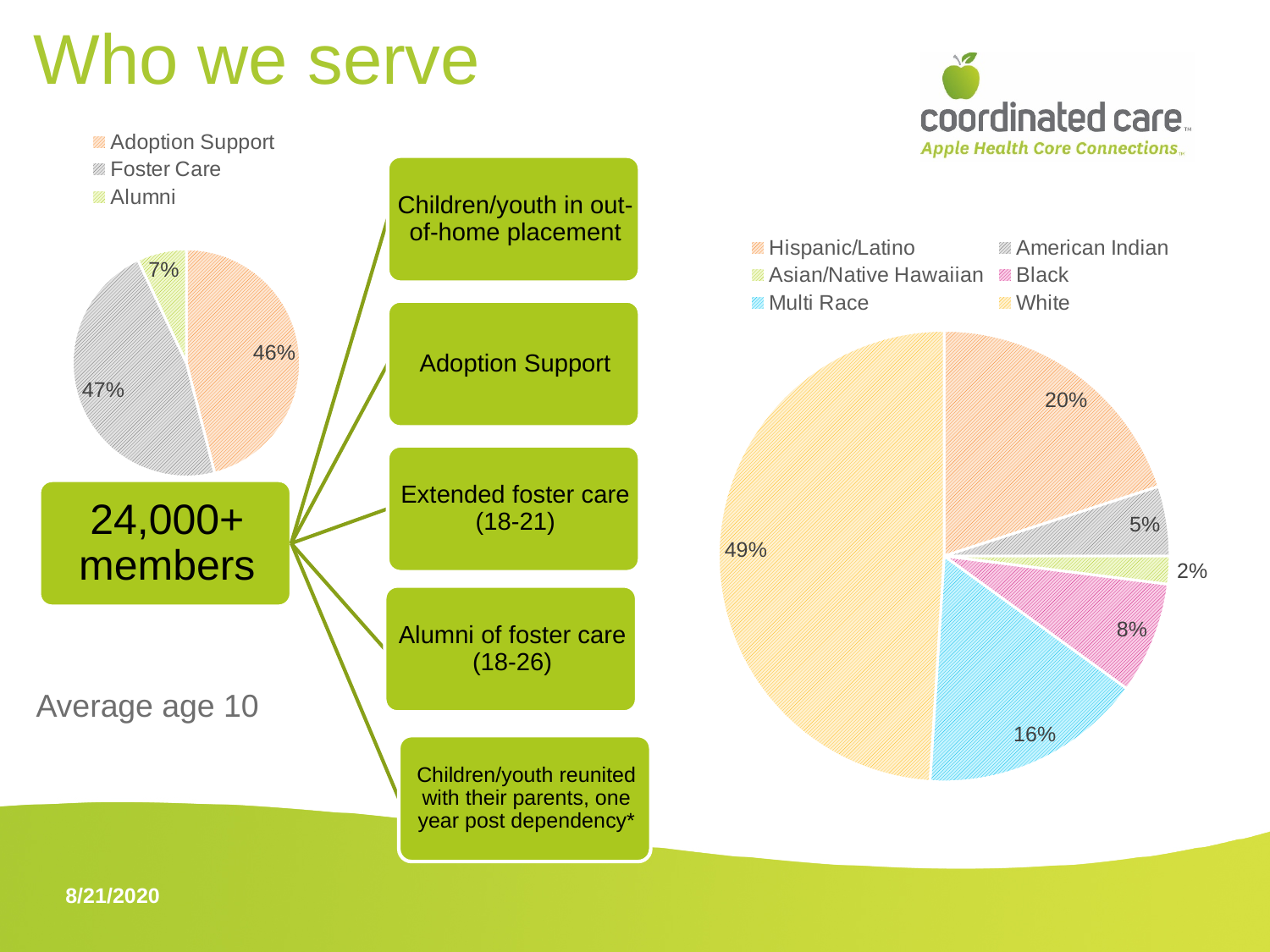
On the right pie chart, what share is Black? 8% On the left pie chart, which category has the smallest share? Alumni On the right pie chart, which is larger, Multi Race or Black? Multi Race On the right pie chart, what share is White? 49% On the left pie chart, what share is Adoption Support? 46% What type of chart is the chart on the right of the slide? Pie chart On the right pie chart, which category has the smallest share? Asian/Native Hawaiian On the right pie chart, which category has the largest share? White On the right pie chart, what share is Multi Race? 16% On the left pie chart, what share is Foster Care? 47% How many categories does the legend of the left pie chart list? 3 On the right pie chart, what is the difference between the Hispanic/Latino share and the American Indian share? 15%